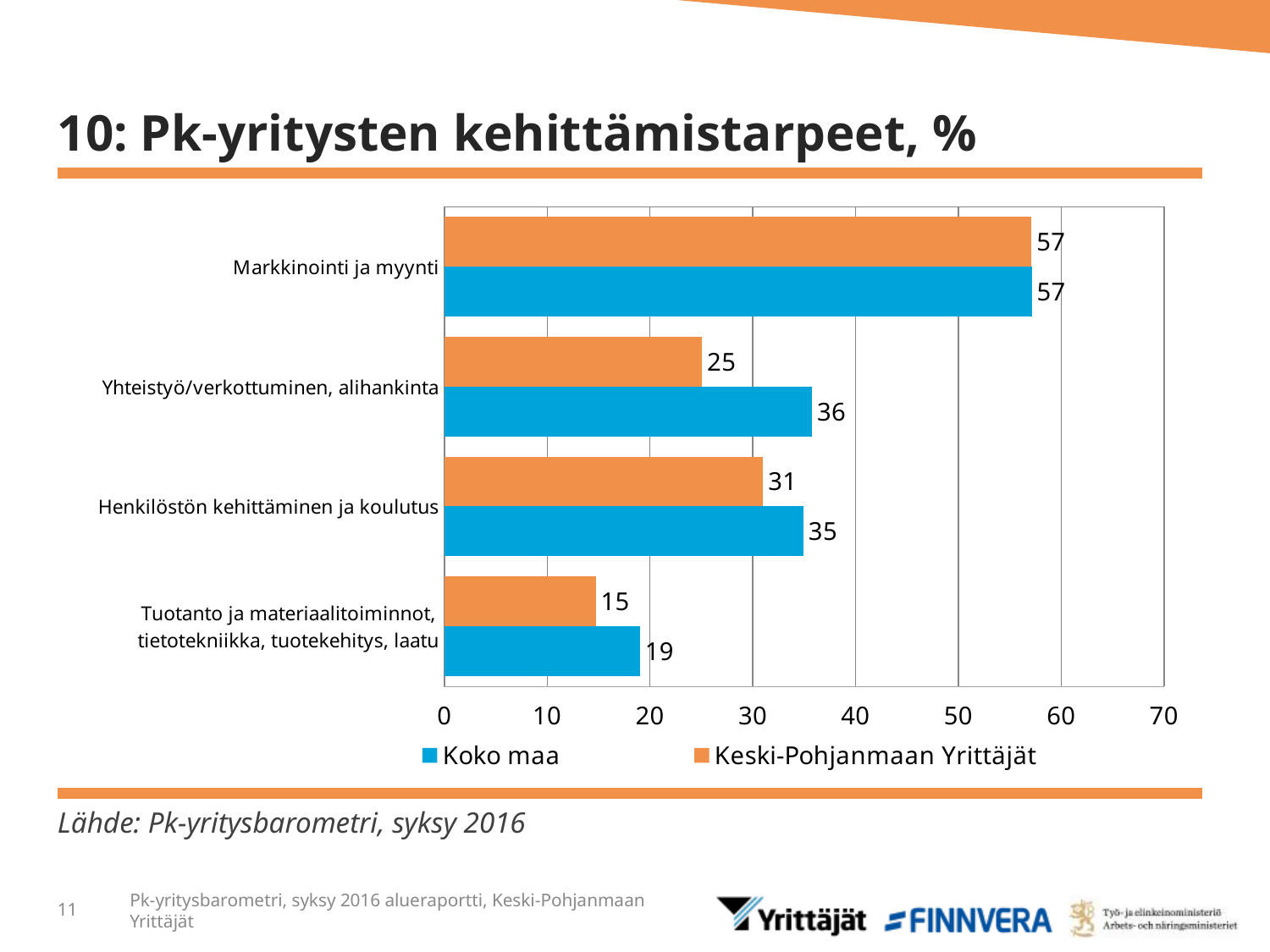
Which category has the highest value for Koko maa? Markkinointi ja myynti What kind of chart is shown on the slide? Bar chart What is the value for Koko maa in the Henkilöstön kehittäminen ja koulutus category? 35 What is the value for Koko maa in the Markkinointi ja myynti category? 57 Which category has the lowest value for Keski-Pohjanmaan Yrittäjät? Tuotanto ja materiaalitoiminnot, tietotekniikka, tuotekehitys, laatu What is the value for Keski-Pohjanmaan Yrittäjät in the Yhteistyö/verkottuminen, alihankinta category? 25 What is the difference between Koko maa and Keski-Pohjanmaan Yrittäjät in the Yhteistyö/verkottuminen, alihankinta category? 11 How many categories are shown on the chart? 4 What colour are the bars for Keski-Pohjanmaan Yrittäjät? Orange In the Henkilöstön kehittäminen ja koulutus category, which series has the larger value, Koko maa or Keski-Pohjanmaan Yrittäjät? Koko maa What is the value for Keski-Pohjanmaan Yrittäjät in the Tuotanto ja materiaalitoiminnot, tietotekniikka, tuotekehitys, laatu category? 15 How many series does the legend list? 2